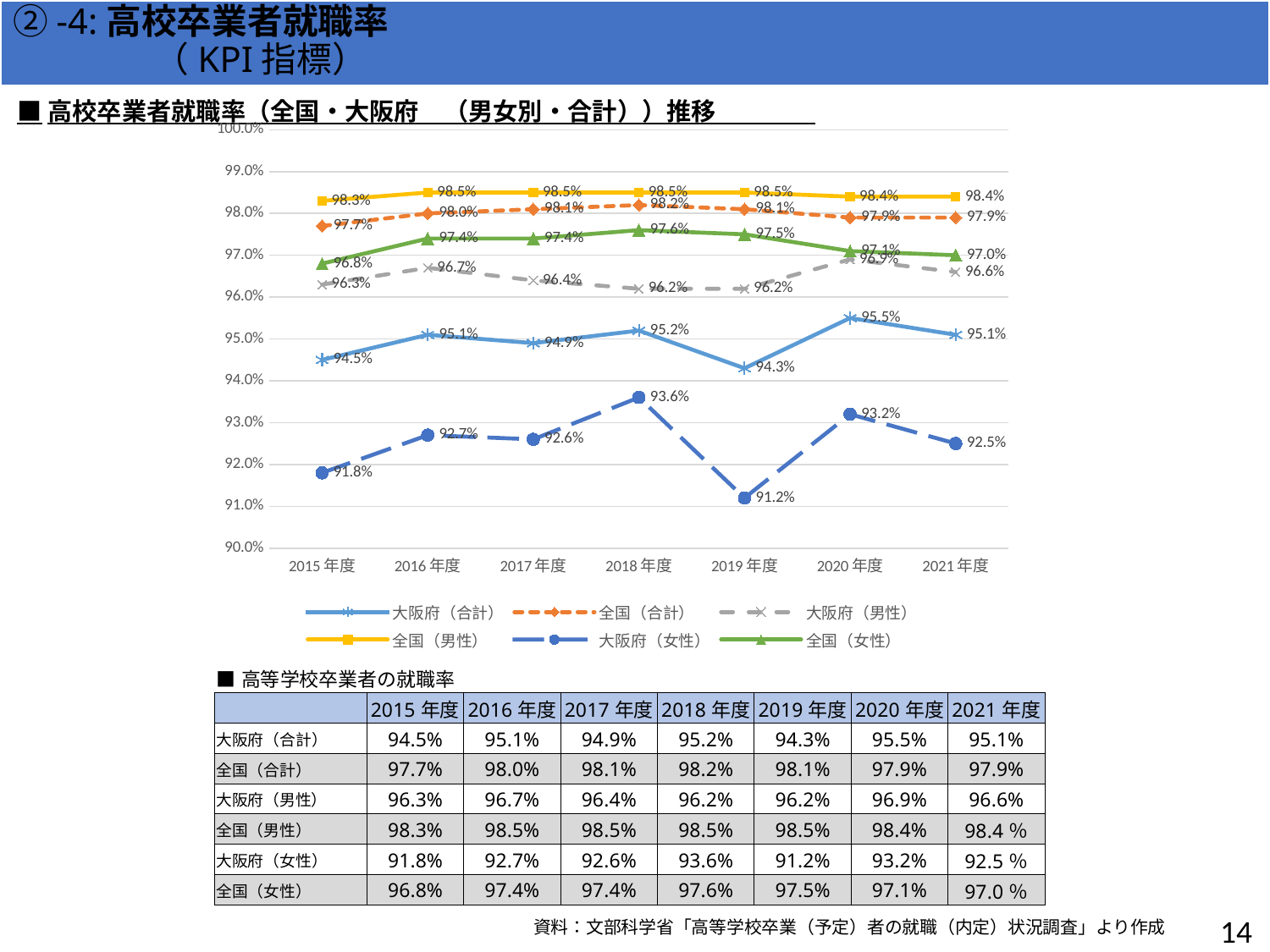
Which series is drawn in yellow? 全国（男性） What is the difference between 全国（男性） and 大阪府（女性） in 2015年度? 6.5 percentage points Which is larger in 2021年度: 大阪府（男性） or 全国（女性）? 全国（女性） In which year is the value for 大阪府（合計） highest? 2020年度 How many series does the legend list? 6 What is the value for 大阪府（女性） in 2019年度? 91.2% How many years are plotted on the x axis? 7 What is the value for 全国（合計） in 2018年度? 98.2% Is the value for 大阪府（女性） in 2018年度 greater or less than 93.0%? greater What is the difference between the 大阪府（合計） values for 2020年度 and 2019年度? 1.2 percentage points In which year is the value for 大阪府（女性） lowest? 2019年度 What kind of chart is shown? line chart